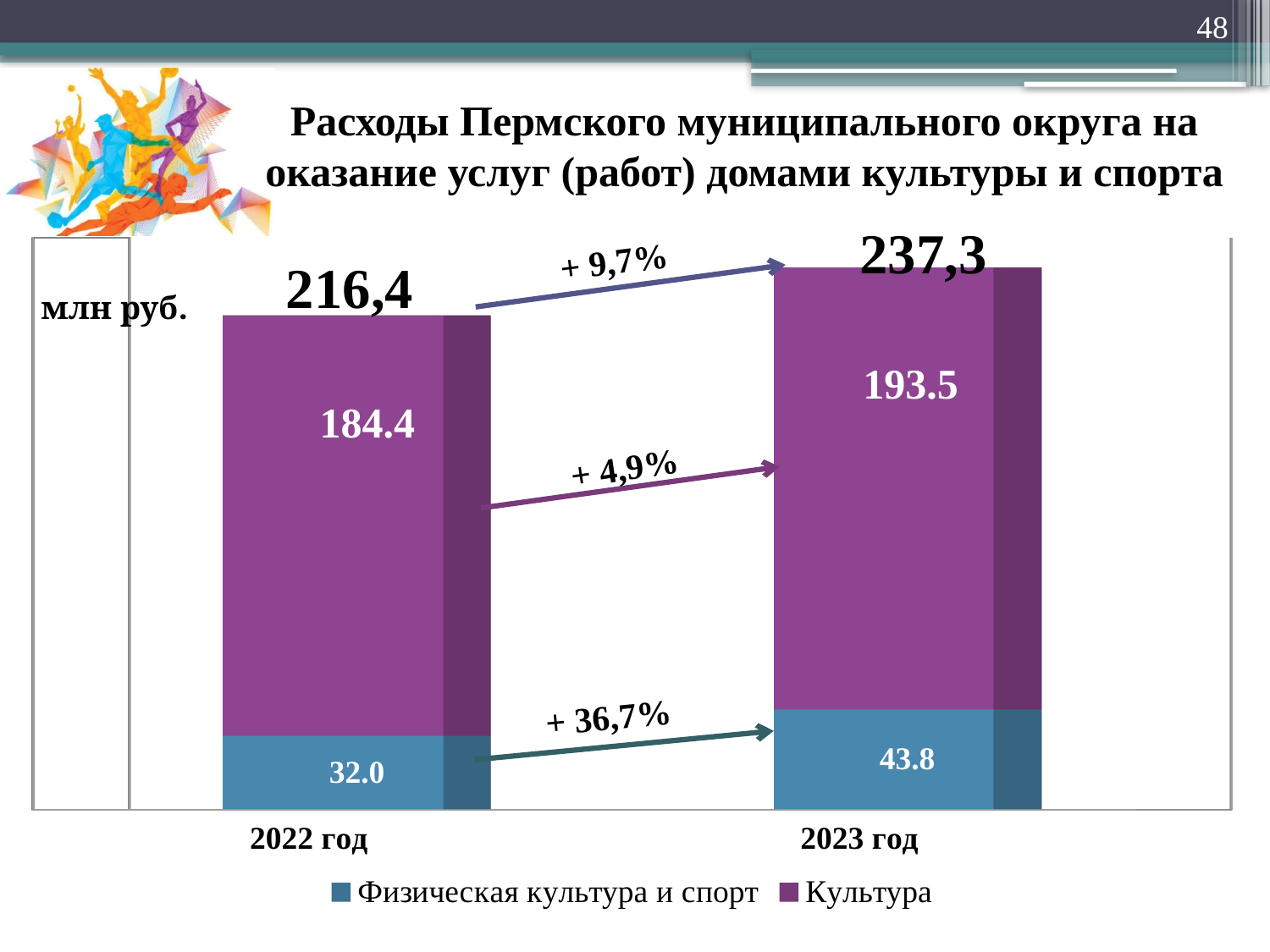
How many categories are shown on the x axis? 2 Which year has the higher value for Культура, 2022 год or 2023 год? 2023 год What is the difference between the Физическая культура и спорт values for 2023 год and 2022 год? 11.8 What is the value for Культура in 2023 год? 193.5 How many series does the legend list? 2 What is the total of the stacked bar for 2023 год? 237,3 What is the value for Физическая культура и спорт in 2022 год? 32.0 What is the value for Физическая культура и спорт in 2023 год? 43.8 What is the total of the stacked bar for 2022 год? 216,4 What kind of chart is shown on the slide? Stacked bar chart What percentage growth is shown for Физическая культура и спорт from 2022 год to 2023 год? + 36,7% What is the value for Культура in 2022 год? 184.4